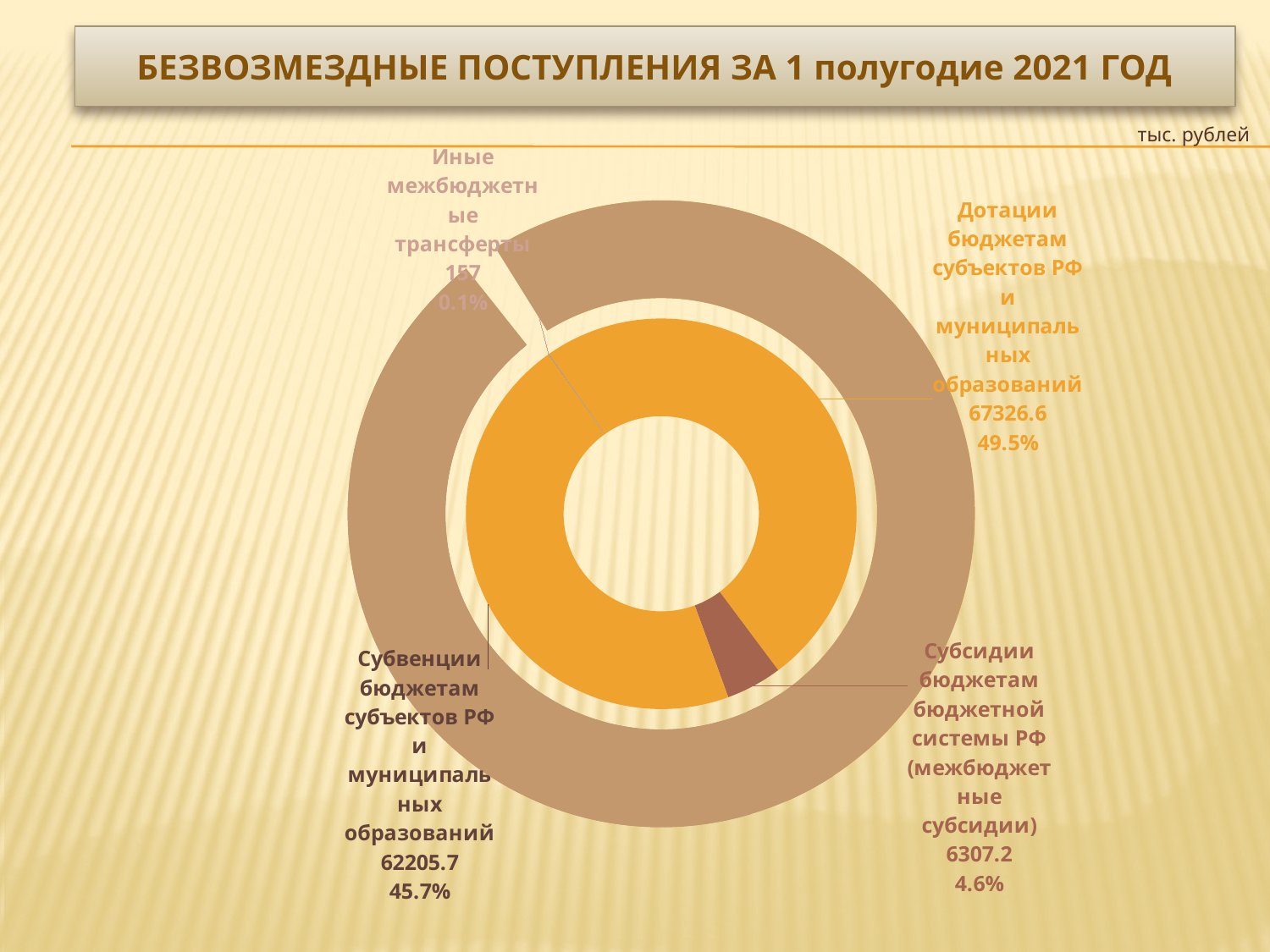
What share of the chart does Субсидии бюджетам бюджетной системы РФ (межбюджетные субсидии) represent? 4.6% What is the value for Субвенции бюджетам субъектов РФ и муниципальных образований? 62205.7 What is the value for Дотации бюджетам субъектов РФ и муниципальных образований? 67326.6 Which category has the highest value? Дотации бюджетам субъектов РФ и муниципальных образований What share of the chart does Субвенции бюджетам субъектов РФ и муниципальных образований represent? 45.7% What kind of chart is shown on the slide? Doughnut chart What is the difference between the values for Дотации and Субвенции? 5120.9 How many categories are shown in the chart? 4 What is the value for Иные межбюджетные трансферты? 157 Which category has the lowest value? Иные межбюджетные трансферты Which is larger, the value for Субсидии or the value for Иные межбюджетные трансферты? Субсидии What is the value for Субсидии бюджетам бюджетной системы РФ (межбюджетные субсидии)? 6307.2